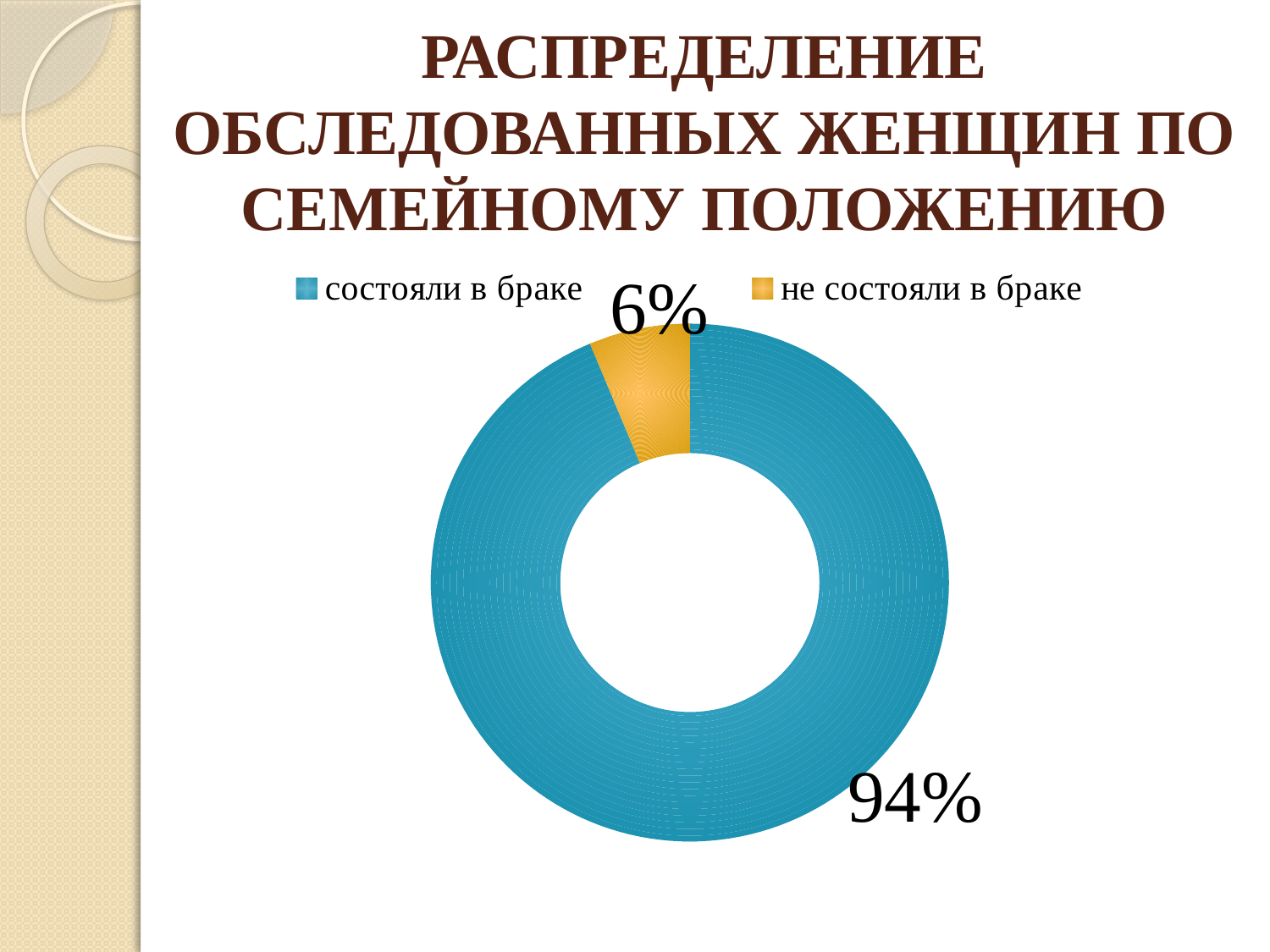
Which category has the smallest share of the chart? не состояли в браке What share of the surveyed women were married (состояли в браке)? 94% Which category has the largest share of the chart? состояли в браке What kind of chart is shown on the slide? Doughnut (pie) chart What is the title of the slide containing the chart? РАСПРЕДЕЛЕНИЕ ОБСЛЕДОВАННЫХ ЖЕНЩИН ПО СЕМЕЙНОМУ ПОЛОЖЕНИЮ How many categories are shown in the chart? 2 What colour represents 'не состояли в браке' in the chart? Yellow/orange What is the difference in percentage points between the married and not married shares? 88% Which is larger: the share for 'состояли в браке' or for 'не состояли в браке'? состояли в браке What share of the surveyed women were not married (не состояли в браке)? 6% How many entries does the legend list? 2 What is the total of the two shares shown in the chart? 100%